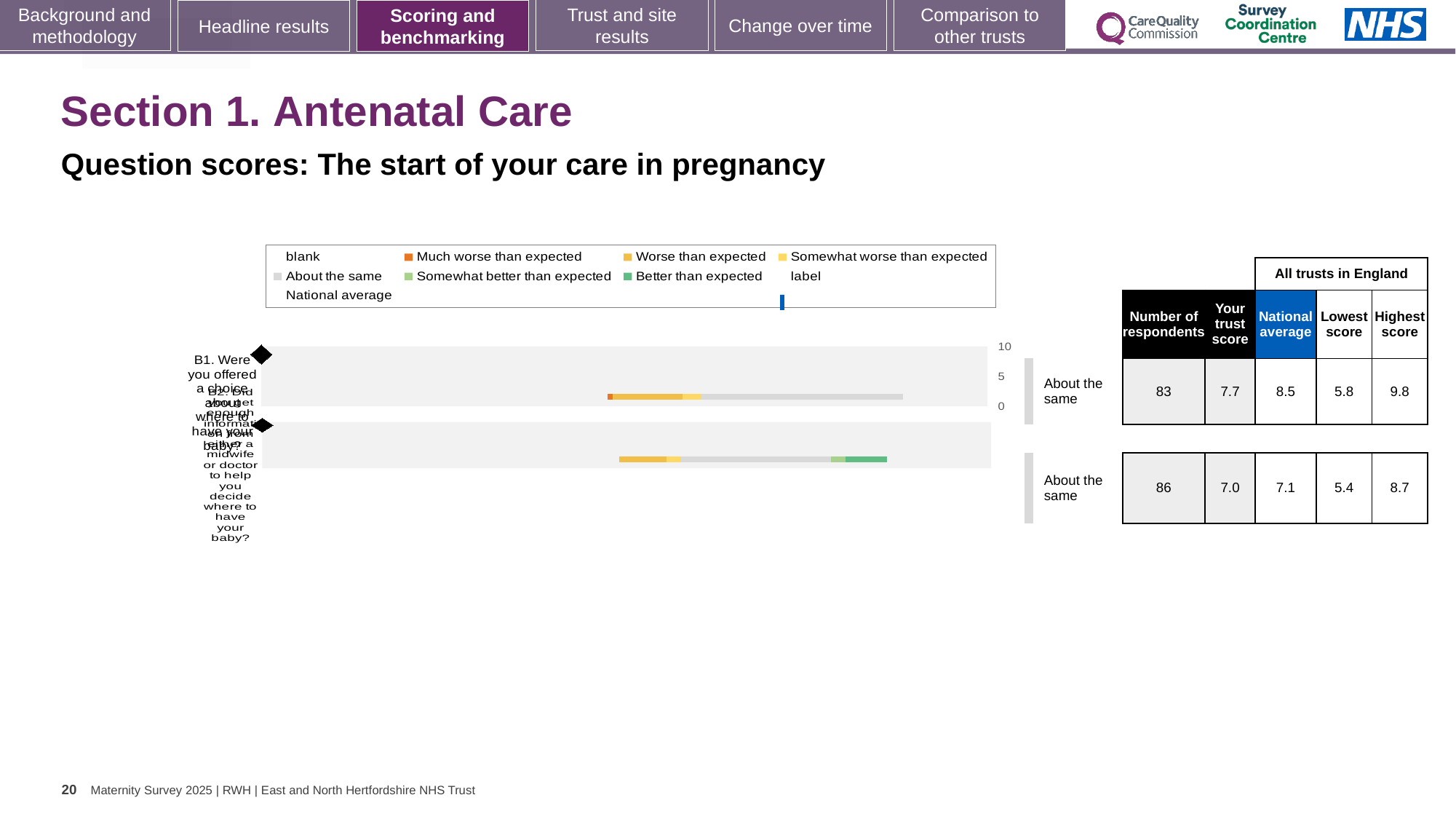
Which question had more respondents, B1 or B2? B2 How many respondents answered question B1? 83 According to the table beside the chart, what is the trust score for B1 (Were you offered a choice about where to have your baby)? 7.7 What is the lowest score across all trusts in England for B2? 5.4 How many survey questions (bars) are plotted in the chart? 2 In the chart legend, what colour represents 'Better than expected'? Green What kind of chart is used to show the question scores for the start of your care in pregnancy? bar chart For B1, which is larger: the trust score or the national average? National average For B2, how much higher is the national average than the trust score? 0.1 What benchmark category is shown next to the chart for question B1? About the same What is the difference between the highest score and the lowest score across all trusts in England for B1? 4.0 According to the table beside the chart, what is the national average for B2 (Did you get enough information from a midwife or doctor to help you decide where to have your baby)? 7.1